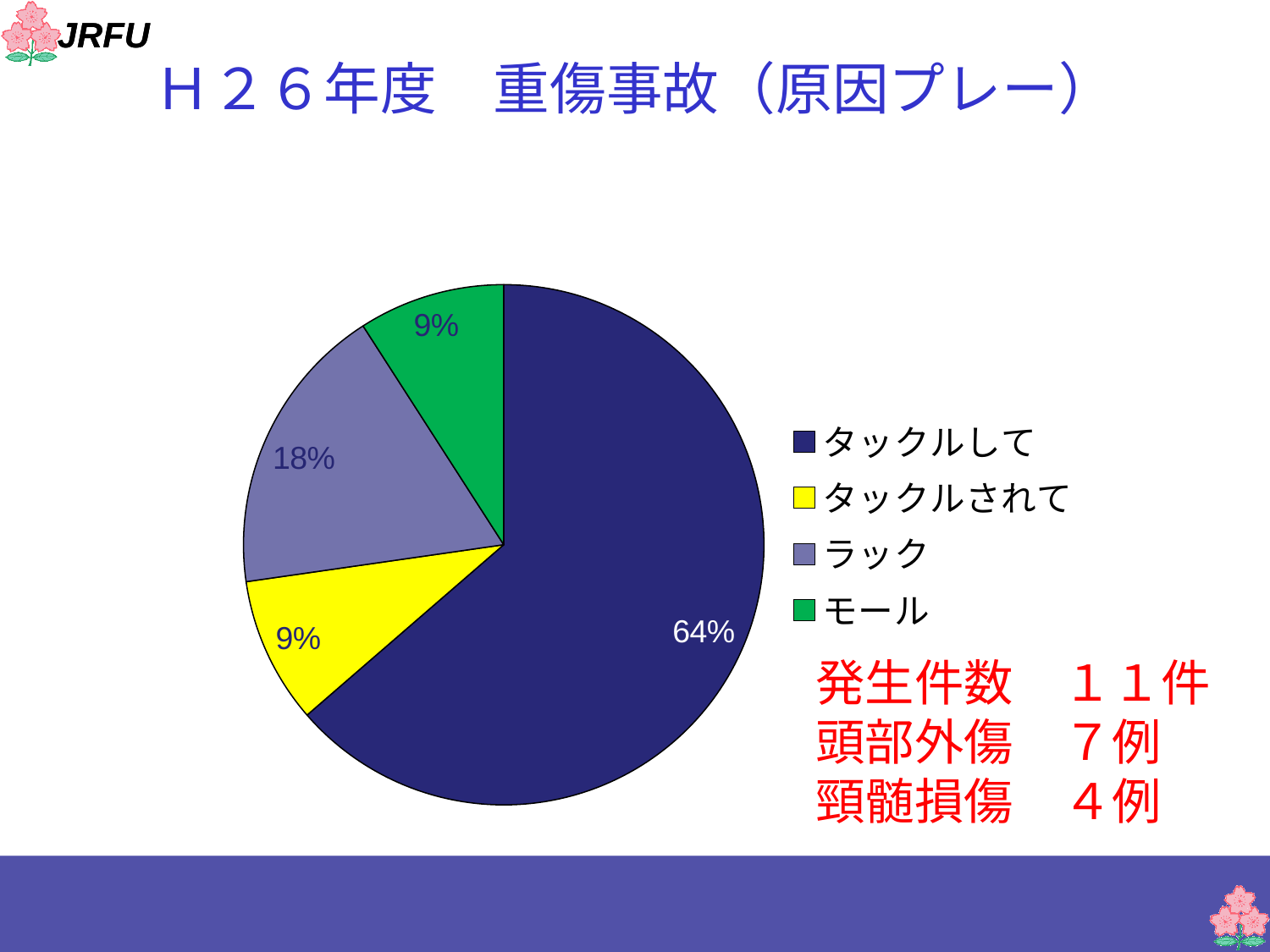
Which category has the largest slice of the pie? タックルして What share of the pie does ラック account for? 18% Which is larger, the ラック slice or the モール slice? ラック How many entries does the legend list? 4 What kind of chart is shown on the slide? pie chart What share of the pie does タックルされて account for? 9% What share of the pie does タックルして account for? 64% What is the difference in percentage points between the タックルして slice and the ラック slice? 46 How many slices does the pie chart have? 4 What is the title of the chart on the slide? Ｈ２６年度 重傷事故（原因プレー） Which legend entry is shown in green? モール